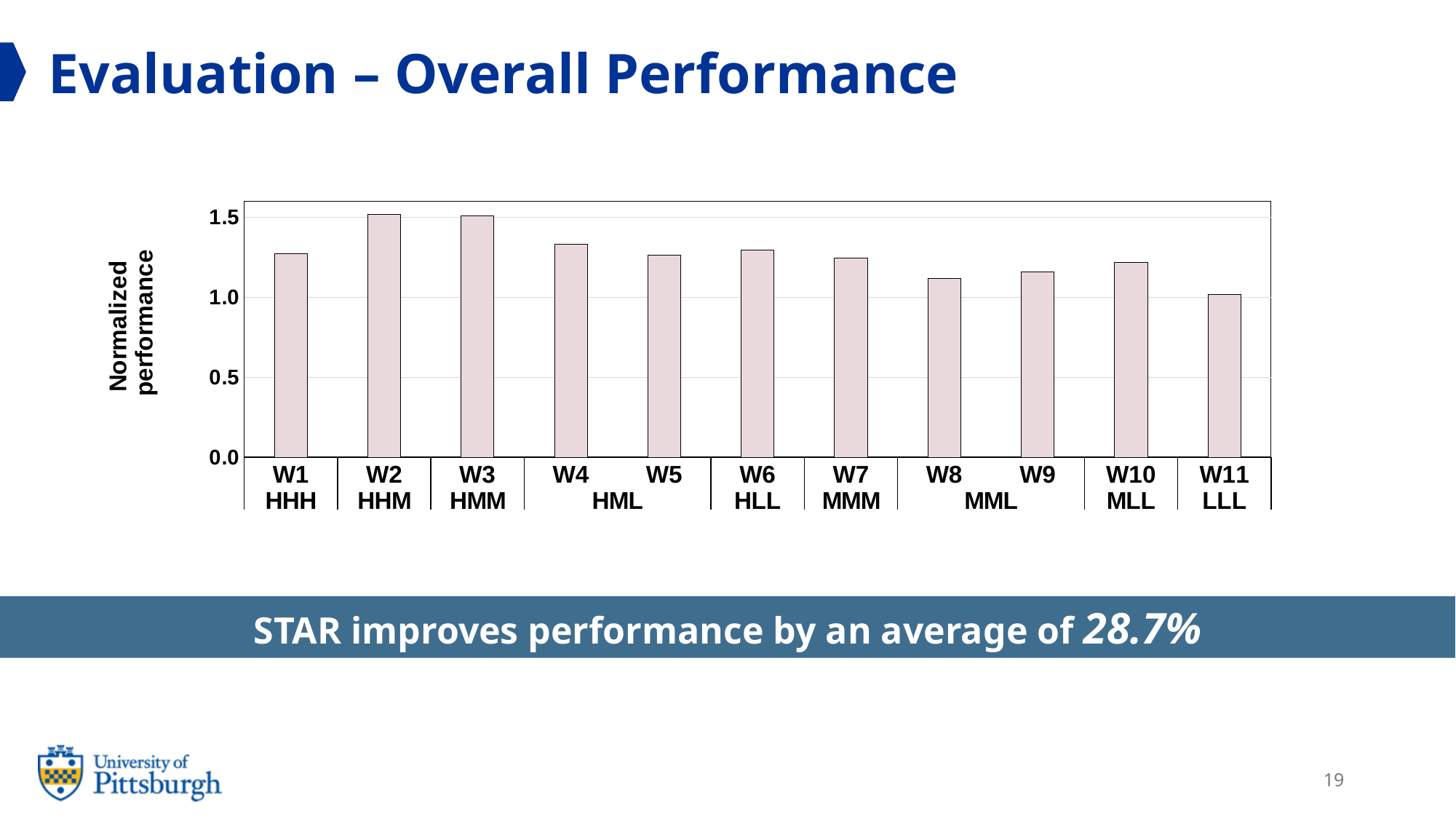
What is the highest value shown on the y-axis? 1.5 Which has a higher normalized performance, W2 or W11? W2 Is the normalized performance for W8 greater or less than 1.0? greater How many workloads (bars) are plotted in the chart? 11 Is the normalized performance for W10 greater or less than 1.5? less Which has a higher normalized performance, W3 or W9? W3 Which workload has the lowest normalized performance? W11 Is the normalized performance for W7 greater or less than 1.0? greater What is the label of the y-axis? Normalized performance What kind of chart is shown on the slide? bar chart Which has a higher normalized performance, W4 or W8? W4